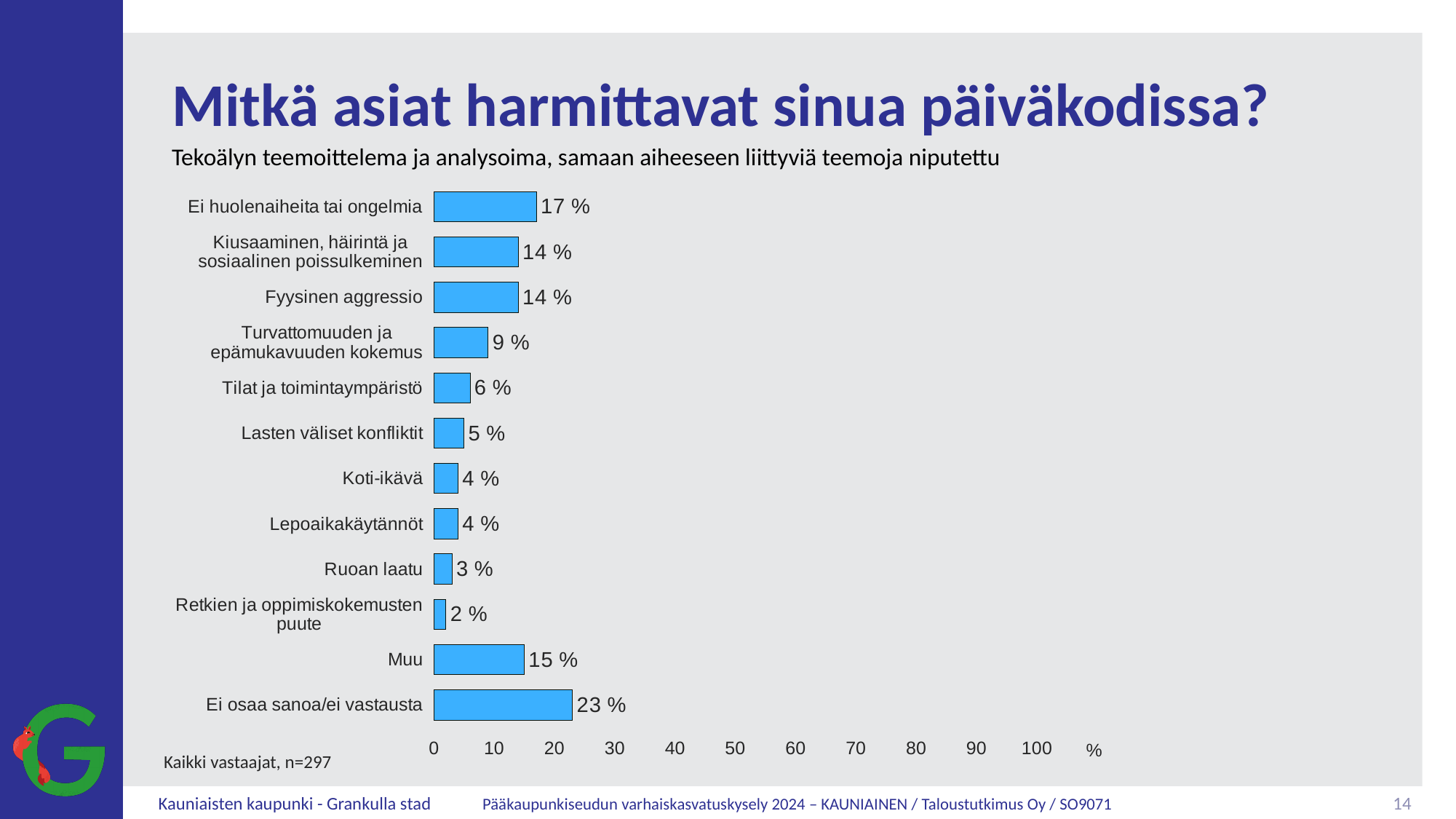
What is the difference between "Ei osaa sanoa/ei vastausta" and "Ei huolenaiheita tai ongelmia"? 6 % Which category has the highest value? Ei osaa sanoa/ei vastausta Which category has the lowest value? Retkien ja oppimiskokemusten puute What is the value for "Muu"? 15 % What is the value for "Fyysinen aggressio"? 14 % How many categories are shown in the chart? 12 What is the sample size stated below the chart? n=297 Which is larger, "Turvattomuuden ja epämukavuuden kokemus" or "Lasten väliset konfliktit"? Turvattomuuden ja epämukavuuden kokemus What is the value for "Ei huolenaiheita tai ongelmia"? 17 % What is the value for "Tilat ja toimintaympäristö"? 6 % Is the value for "Ei osaa sanoa/ei vastausta" greater or less than 20? greater What kind of chart is shown on the slide? bar chart